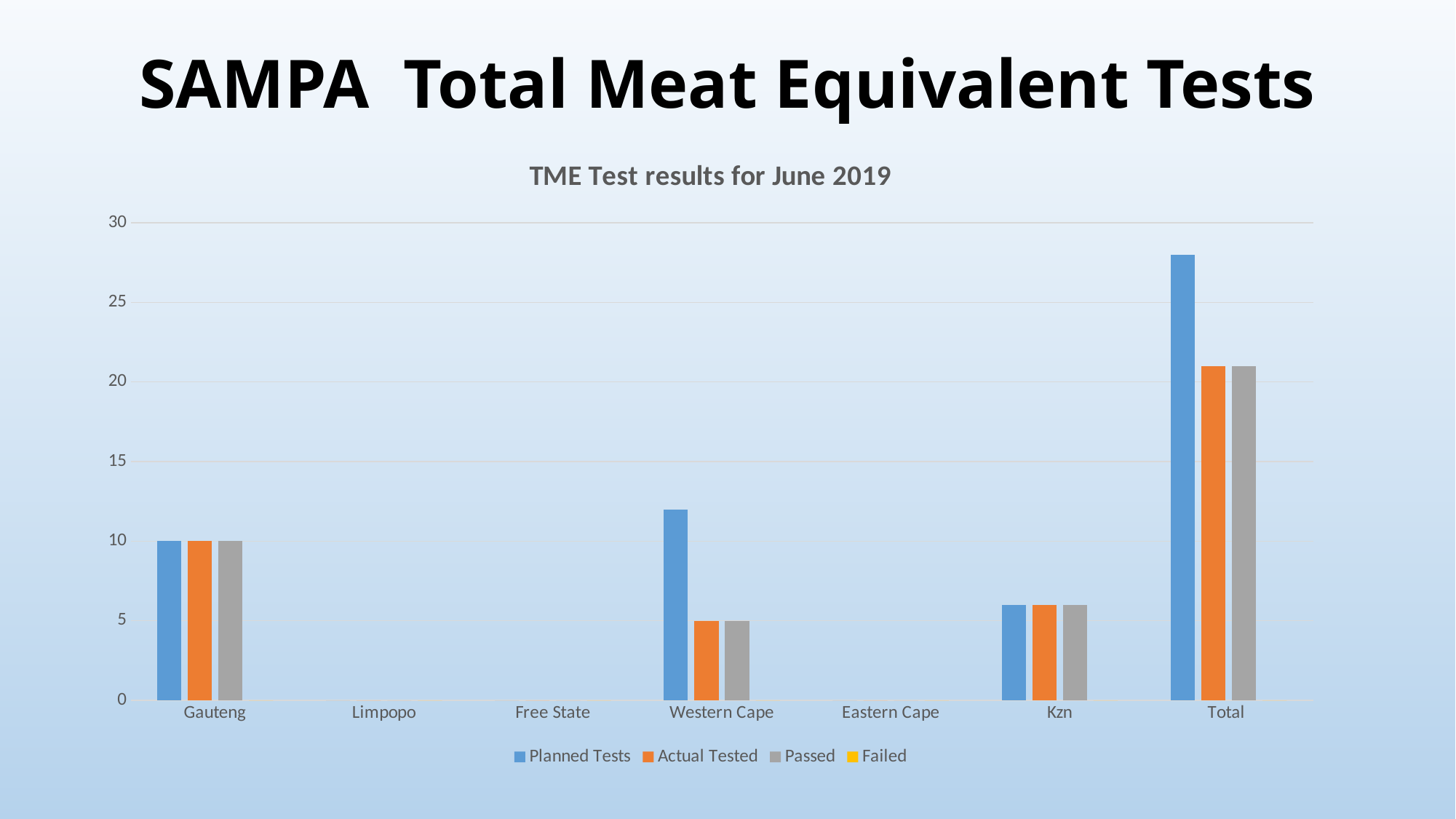
Is the Planned Tests value for Total greater or less than 25? greater What type of chart is shown on the slide? bar chart Is the Planned Tests value for Western Cape greater or less than 10? greater How many categories are shown on the x axis? 7 How many series does the legend list? 4 What is the title of the chart? TME Test results for June 2019 What is the value of Actual Tested for Western Cape? 5 What is the value of Passed for Western Cape? 5 What is the value of Planned Tests for Gauteng? 10 Which category has the highest Planned Tests value? Total Which is larger for Western Cape, Planned Tests or Actual Tested? Planned Tests Is the Actual Tested value for Kzn greater or less than 10? less